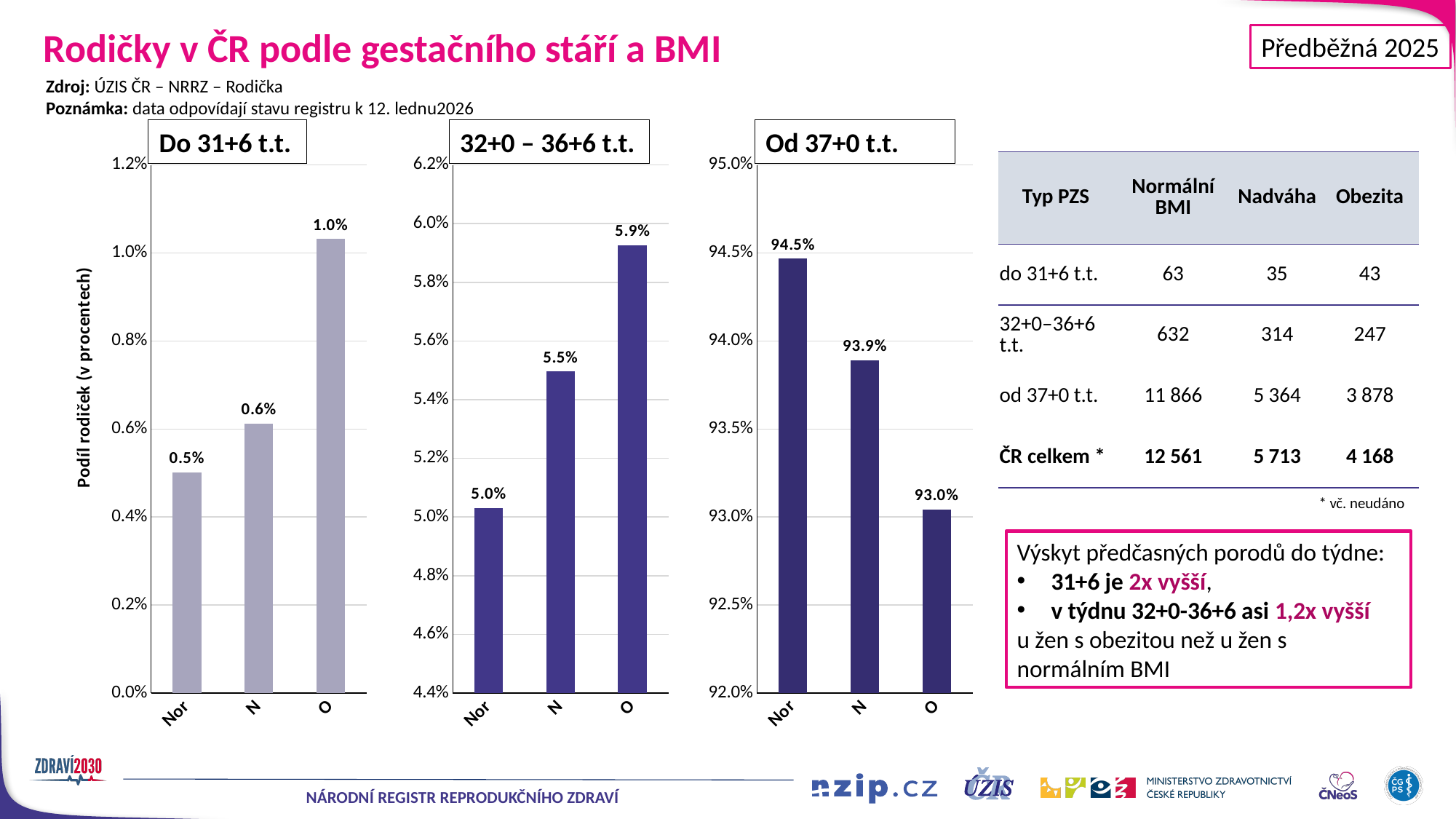
How many categories are shown on the x axis of the chart titled "Do 31+6 t.t."? 3 In the chart titled "Do 31+6 t.t.", which category has the highest value? O In the chart titled "Od 37+0 t.t.", do the values rise or fall from Nor to O? fall In the chart titled "Od 37+0 t.t.", what is the difference between the values for Nor and O? 1.5% In the chart titled "Od 37+0 t.t.", what is the value for Nor? 94.5% In the chart titled "Od 37+0 t.t.", which category has the lowest value? O In the chart titled "32+0 – 36+6 t.t.", what is the difference between the values for O and Nor? 0.9% In the chart titled "32+0 – 36+6 t.t.", what is the value for N? 5.5% In the chart titled "Do 31+6 t.t.", what is the value for O? 1.0% In the chart titled "Od 37+0 t.t.", is the value for N greater or less than 94.0%? less In the chart titled "32+0 – 36+6 t.t.", which is larger, the value for Nor or the value for O? O What kind of chart is the chart titled "Od 37+0 t.t."? bar chart